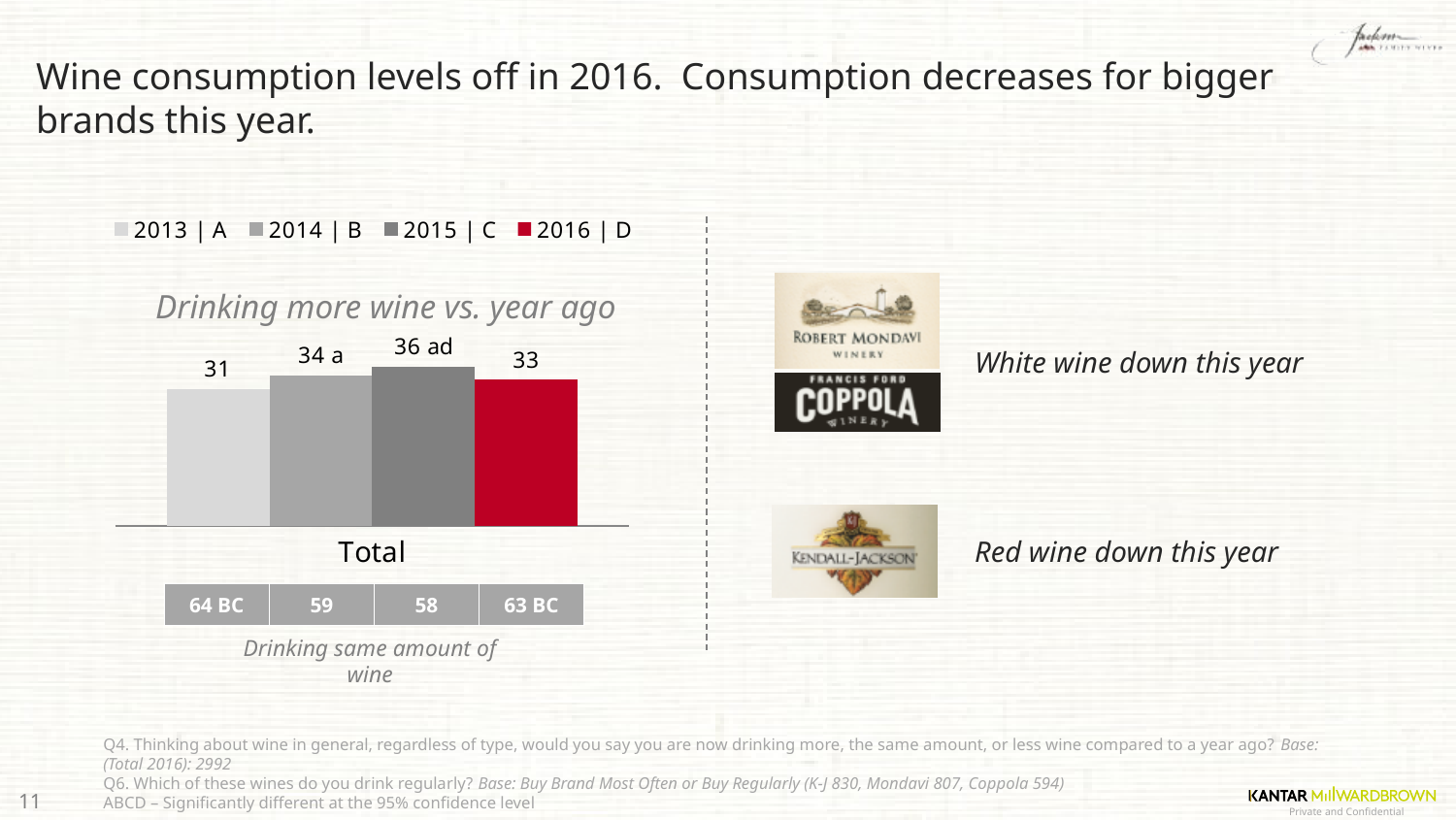
In the 'Drinking more wine vs. year ago' chart, which is larger, the value for 2014 | B or the value for 2016 | D? 2014 | B In the 'Drinking more wine vs. year ago' chart, how many categories are shown on the x axis? 1 In the 'Drinking more wine vs. year ago' chart, which year has the lowest value? 2013 | A How many series does the legend of the 'Drinking more wine vs. year ago' chart list? 4 In the 'Drinking more wine vs. year ago' chart, what is the value for 2016 | D? 33 In the 'Drinking more wine vs. year ago' chart, what colour is the bar for 2016 | D? Red What kind of chart is 'Drinking more wine vs. year ago'? Bar chart In the 'Drinking more wine vs. year ago' chart, what is the difference between the 2015 | C value and the 2013 | A value? 5 In the 'Drinking more wine vs. year ago' chart, what is the name of the single category on the x axis? Total In the 'Drinking more wine vs. year ago' chart, what is the value for 2013 | A? 31 In the 'Drinking more wine vs. year ago' chart, what is the data label shown for 2015 | C? 36 ad In the 'Drinking more wine vs. year ago' chart, which year has the highest value? 2015 | C